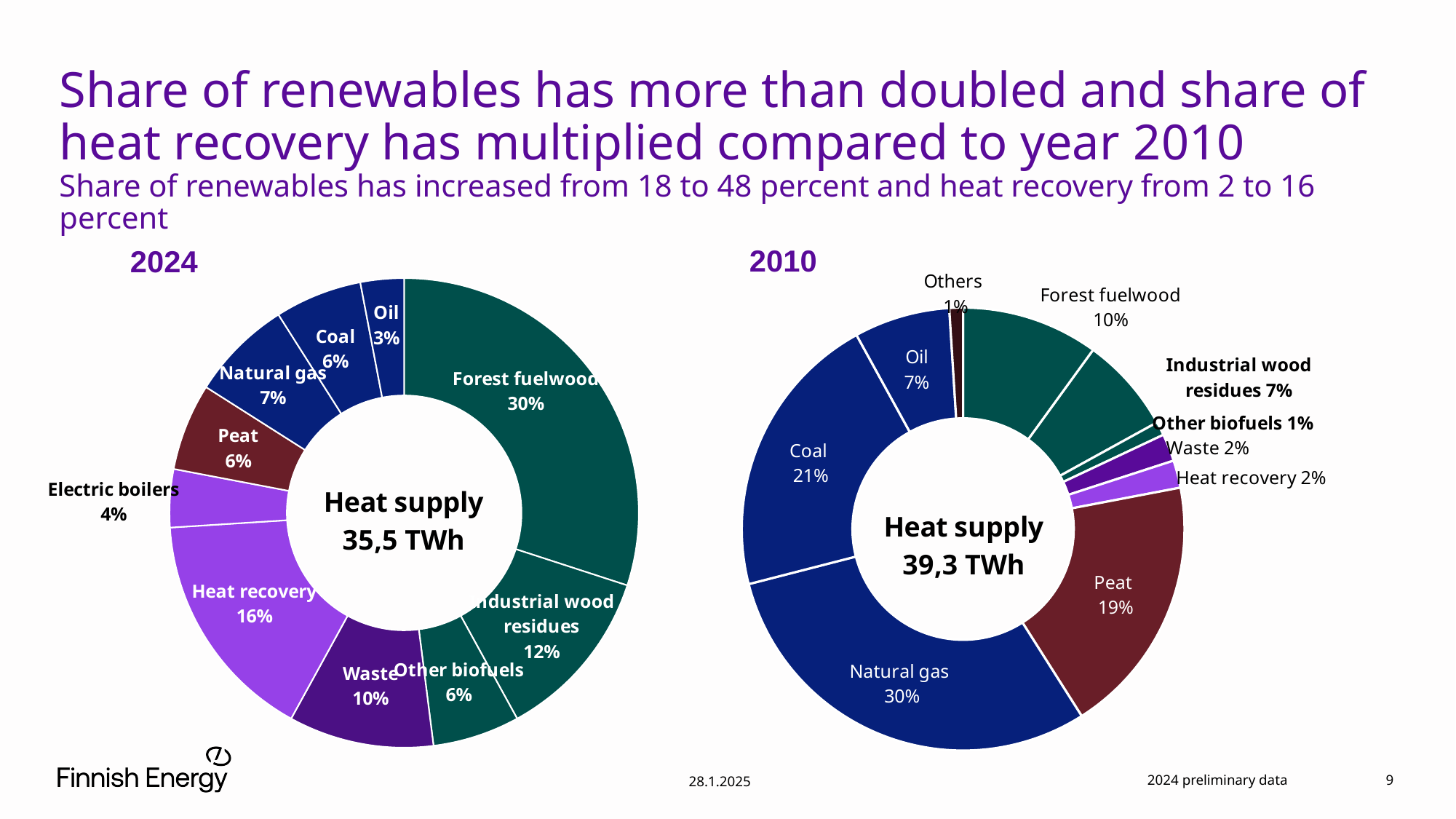
In the 2024 chart, what share of heat supply comes from Forest fuelwood? 30% In the 2024 chart, which category has the smallest share? Oil What is the difference in percentage points between the Coal share in 2010 and the Coal share in 2024? 15 What total heat supply is shown in the centre of the 2024 chart? 35,5 TWh In the 2010 chart, what is the share for Natural gas? 30% In the 2024 chart, which category has the largest share? Forest fuelwood What type of chart is used on this slide? Pie (donut) chart In the 2010 chart, what is the share for Peat? 19% In the 2010 chart, which category has the largest share? Natural gas In the 2024 chart, which is larger: the share for Waste or the share for Natural gas? Waste How many categories are shown in the 2010 chart? 10 In the 2024 chart, what is the share for Heat recovery? 16%